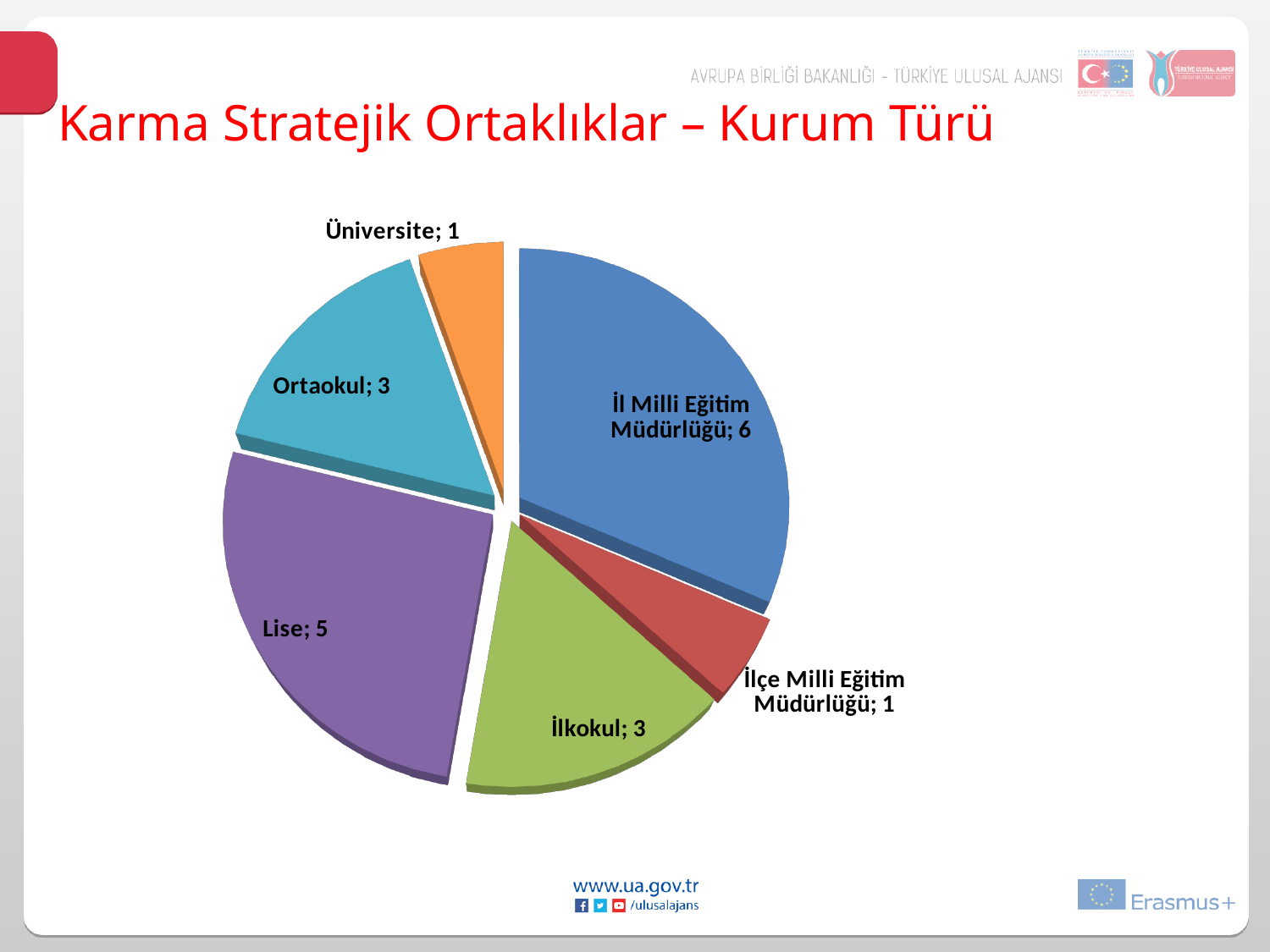
What is the title of the slide containing the chart? Karma Stratejik Ortaklıklar – Kurum Türü What kind of chart is shown on the slide? pie chart What is the value for Ortaokul? 3 What is the total of all the slice values in the pie chart? 19 Which category has the largest slice of the pie? İl Milli Eğitim Müdürlüğü What is the value for Üniversite? 1 How many slices does the pie chart have? 6 What is the value for İl Milli Eğitim Müdürlüğü? 6 What is the difference between the values for Lise and İlkokul? 2 What is the difference between the values for İl Milli Eğitim Müdürlüğü and Lise? 1 What is the value for Lise? 5 Which is larger, the value for Lise or the value for Ortaokul? Lise